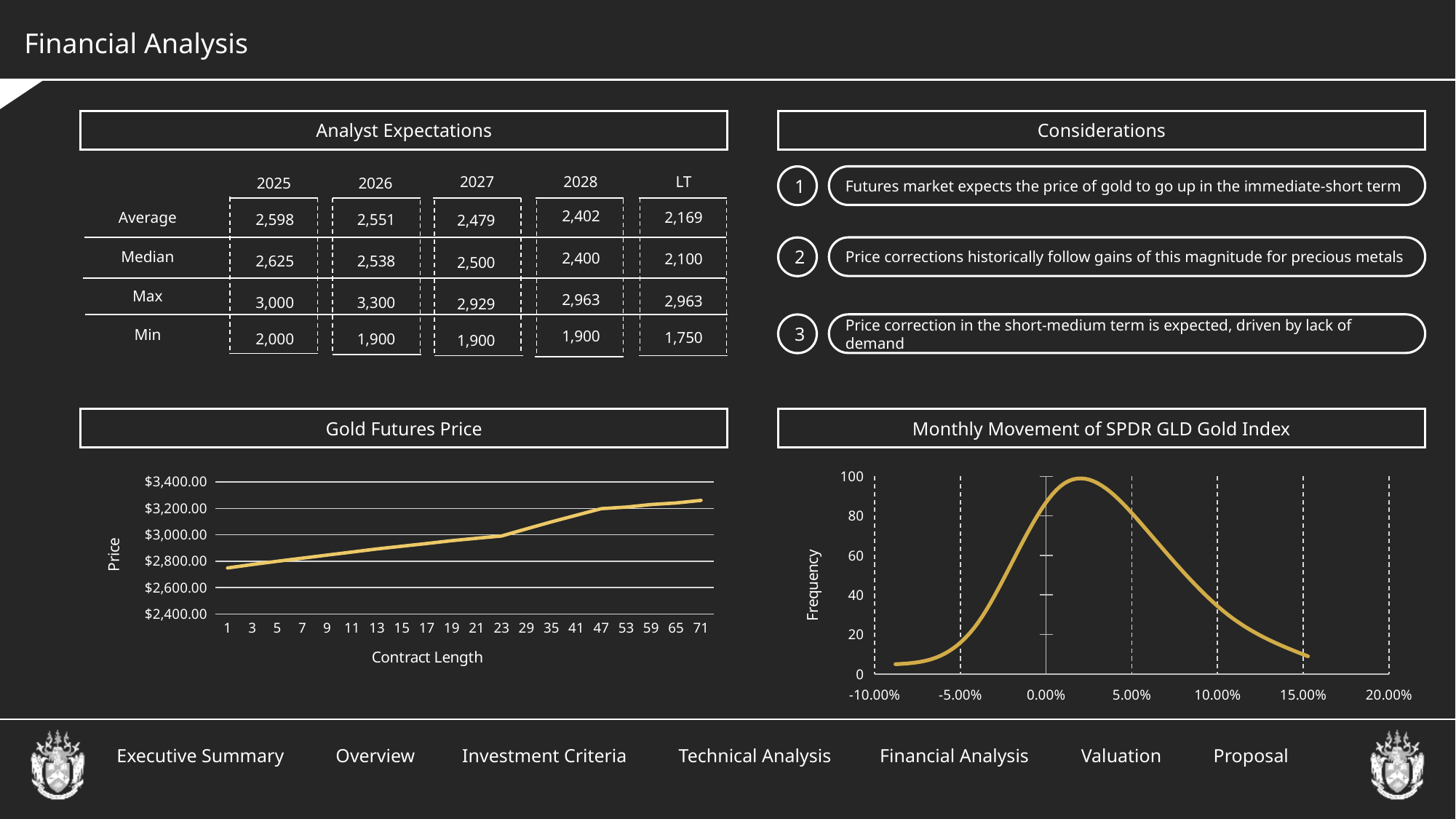
In the Monthly Movement of SPDR GLD Gold Index chart, does the curve rise or fall between 5.00% and 15.00%? fall What kind of chart is the Monthly Movement of SPDR GLD Gold Index chart? line chart What is the y-axis title of the Monthly Movement of SPDR GLD Gold Index chart? Frequency In the Gold Futures Price chart, is the value for contract length 1 greater or less than $2,800.00? less How many contract length categories are shown on the x axis of the Gold Futures Price chart? 20 In the Gold Futures Price chart, is the value for contract length 11 greater or less than $2,800.00? greater What kind of chart is the Gold Futures Price chart? line chart In the Gold Futures Price chart, is the value for contract length 71 greater or less than $3,200.00? greater What is the y-axis title of the Gold Futures Price chart? Price In the Gold Futures Price chart, do the values rise or fall as contract length increases? rise